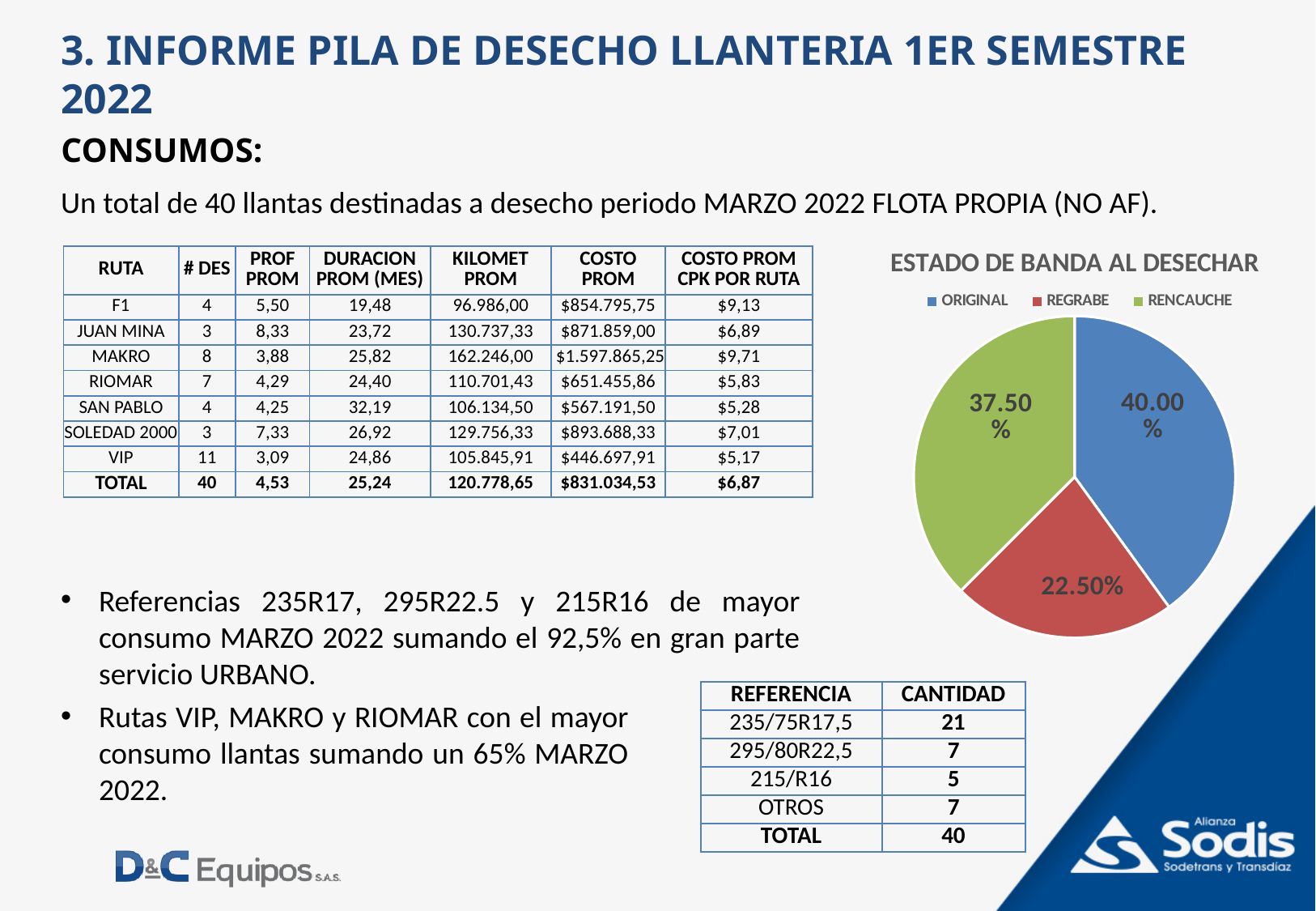
What type of chart is "ESTADO DE BANDA AL DESECHAR"? pie chart How many slices does the pie chart "ESTADO DE BANDA AL DESECHAR" have? 3 In the pie chart "ESTADO DE BANDA AL DESECHAR", which colour represents REGRABE? red How many entries does the legend of the pie chart "ESTADO DE BANDA AL DESECHAR" list? 3 In the pie chart "ESTADO DE BANDA AL DESECHAR", what is the difference between the ORIGINAL and REGRABE shares? 17.50% In the pie chart "ESTADO DE BANDA AL DESECHAR", what share does RENCAUCHE have? 37.50% Which category has the smallest slice in the pie chart "ESTADO DE BANDA AL DESECHAR"? REGRABE In the pie chart "ESTADO DE BANDA AL DESECHAR", what share does ORIGINAL have? 40.00% Which category has the largest slice in the pie chart "ESTADO DE BANDA AL DESECHAR"? ORIGINAL In the pie chart "ESTADO DE BANDA AL DESECHAR", what share does REGRABE have? 22.50% In the pie chart "ESTADO DE BANDA AL DESECHAR", which is larger, RENCAUCHE or REGRABE? RENCAUCHE What is the title of the pie chart on the slide? ESTADO DE BANDA AL DESECHAR